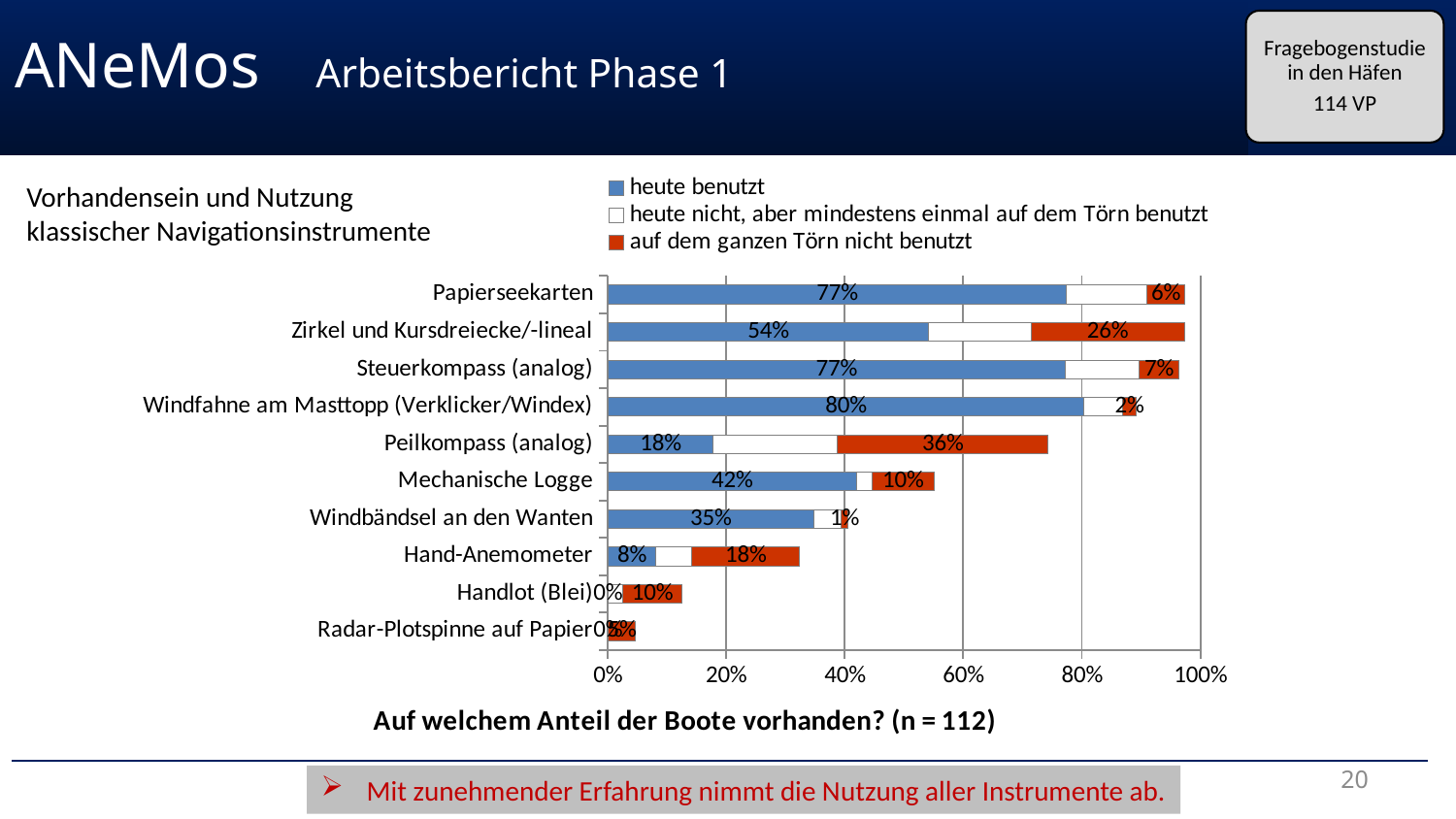
Which has the larger "auf dem ganzen Törn nicht benutzt" value: Zirkel und Kursdreiecke/-lineal or Papierseekarten? Zirkel und Kursdreiecke/-lineal What percentage of boats use Papierseekarten today ("heute benutzt")? 77% Which instrument has the highest "heute benutzt" value? Windfahne am Masttopp (Verklicker/Windex) What is the "auf dem ganzen Törn nicht benutzt" value for Peilkompass (analog)? 36% Is the total bar length for Peilkompass (analog) greater or less than 80%? less What is the "heute benutzt" value for Zirkel und Kursdreiecke/-lineal? 54% How many instruments (categories) are shown in the chart? 10 What kind of chart is shown on the slide? Stacked bar chart What is the "heute benutzt" value for Hand-Anemometer? 8% How many series does the legend list? 3 How many percentage points higher is the "heute benutzt" value for Windfahne am Masttopp than for Zirkel und Kursdreiecke/-lineal? 26 percentage points Which instrument has the highest "auf dem ganzen Törn nicht benutzt" value? Peilkompass (analog)